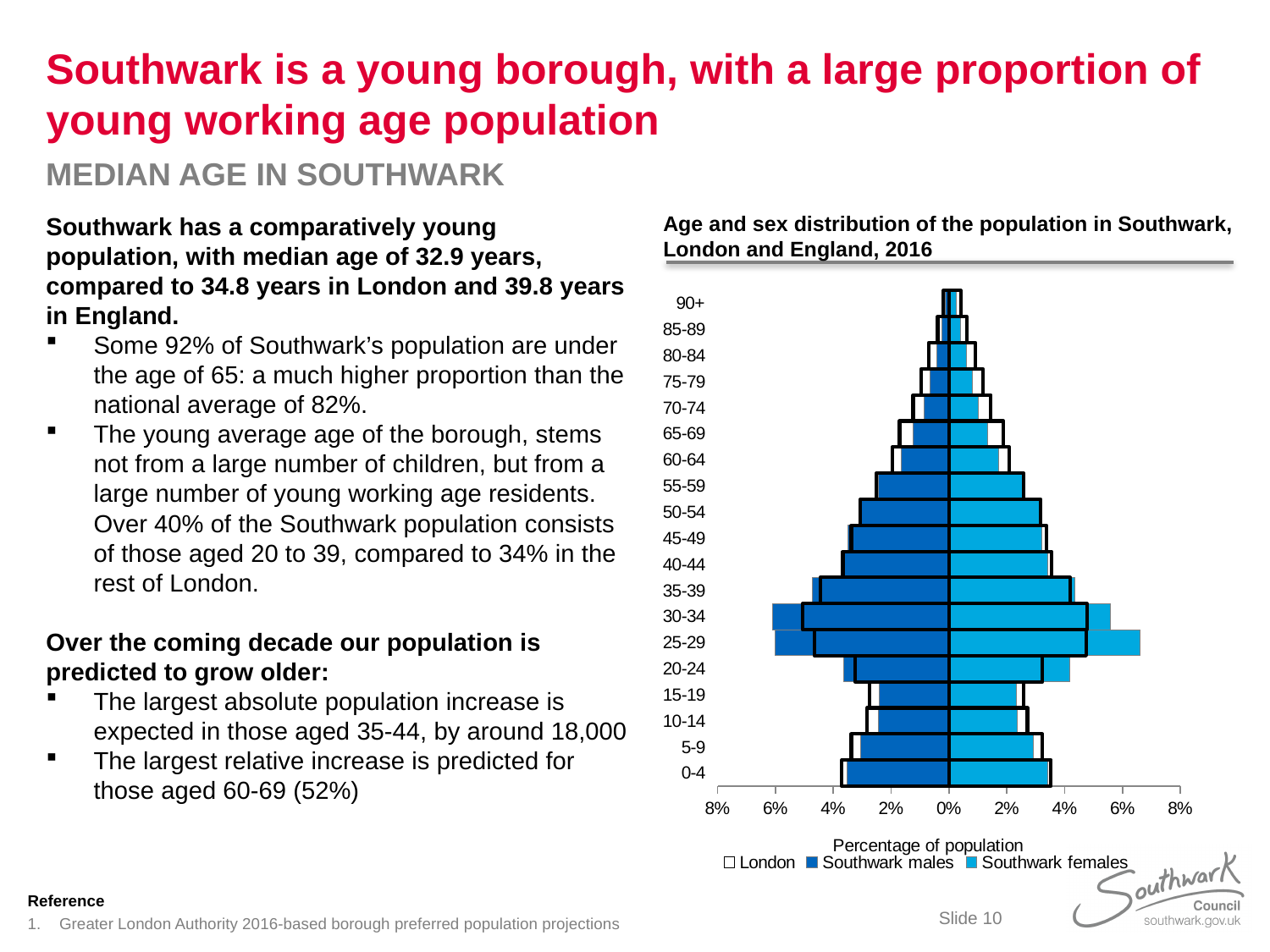
Which age group has the longest Southwark females bar? 25-29 Is the Southwark females value for the 90+ age group greater or less than 2%? less Which age group has the shortest Southwark males bar? 90+ Which age group has the shortest Southwark females bar? 90+ What is the title of the chart? Age and sex distribution of the population in Southwark, London and England, 2016 Is the Southwark females value for the 25-29 age group greater or less than 6%? greater Do the Southwark females bars rise or fall as the age groups go from 30-34 up to 90+? fall What is the label on the horizontal axis of the chart? Percentage of population Is the Southwark males value for the 0-4 age group greater or less than 4%? less What kind of chart is shown on the slide? bar chart How many age groups are shown on the vertical axis of the chart? 19 How many series does the chart legend list? 3